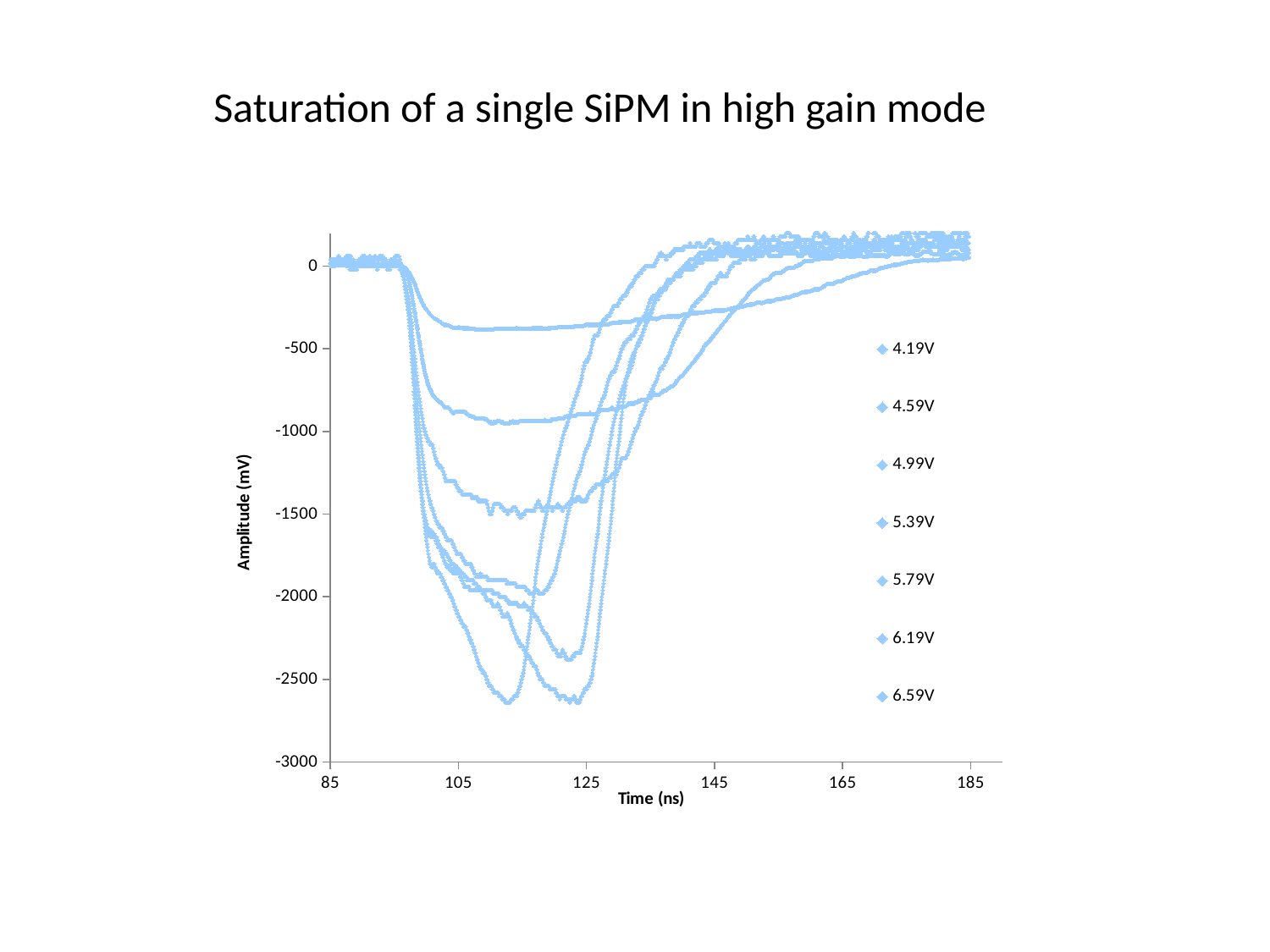
What is the lowest value shown on the y axis? -3000 What is the label of the y axis? Amplitude (mV) How many tick labels are shown on the x axis? 6 Is the lowest amplitude reached by the shallowest curve greater or less than -500? greater What is the first entry listed in the legend? 4.19V How many series does the legend list? 7 What kind of chart is shown on the slide? scatter chart What is the highest value shown on the x axis? 185 Is the lowest amplitude reached by the deepest curve greater or less than -2500? less What is the last entry listed in the legend? 6.59V What is the title of the chart? Saturation of a single SiPM in high gain mode What is the label of the x axis? Time (ns)